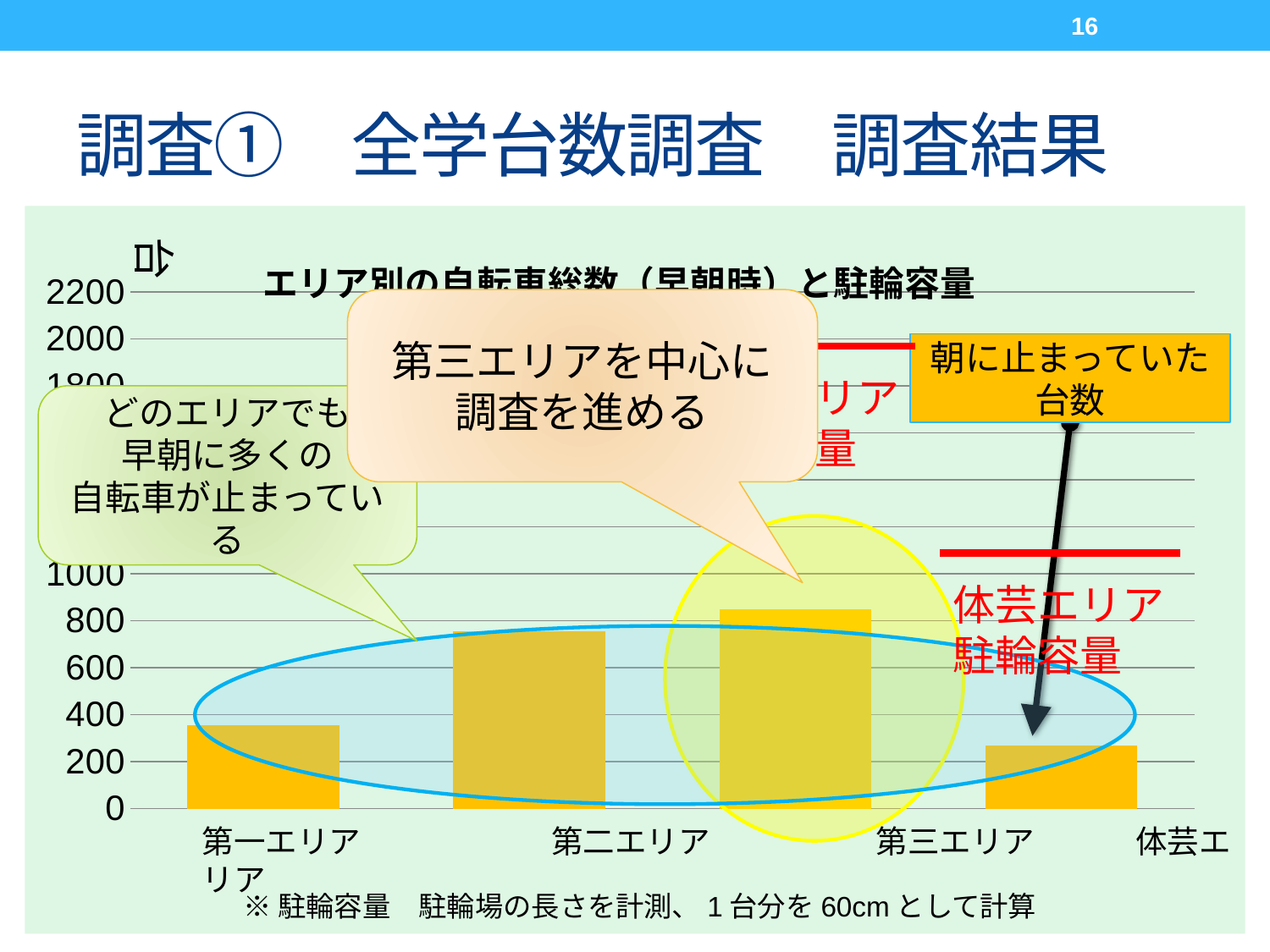
What kind of chart is shown on the slide? bar chart Is the value for 第一エリア greater or less than 400? less What unit is shown at the top of the vertical axis of the chart? 台 Which area has the tallest bar in the chart? 第三エリア Is the value for 第二エリア greater or less than 600? greater How many areas (categories) are plotted on the x axis of the chart? 4 Which is larger, the bar for 第二エリア or the bar for 第一エリア? 第二エリア What is the highest tick value shown on the vertical axis of the chart? 2200 Is the value for 体芸エリア greater or less than 400? less Which is larger, the bar for 第三エリア or the bar for 体芸エリア? 第三エリア Which area has the shortest bar in the chart? 体芸エリア